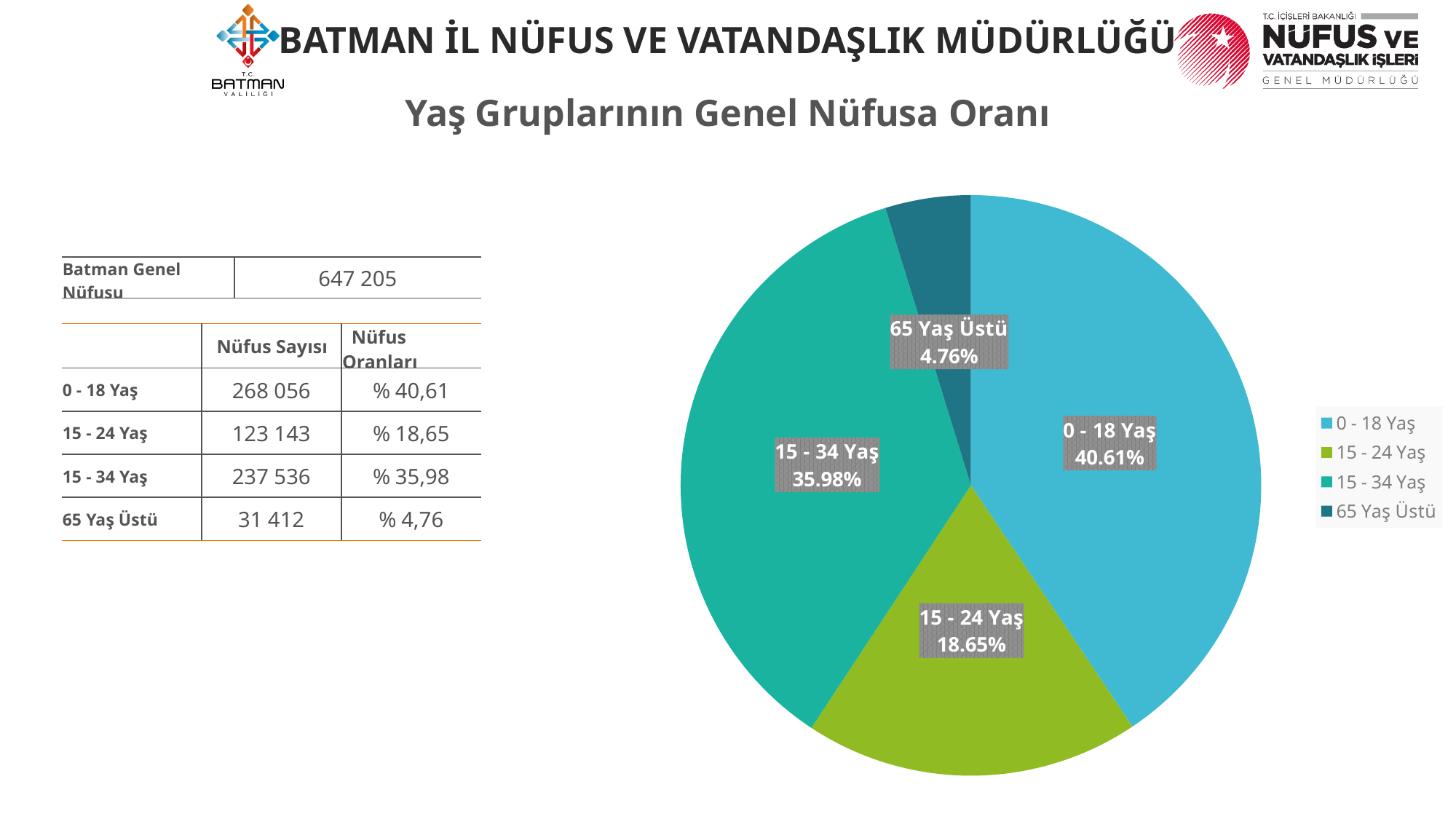
What kind of chart is shown on the slide? Pie chart What percentage does the pie chart show for the 65 Yaş Üstü slice? 4.76% What percentage does the pie chart show for the 0 - 18 Yaş slice? 40.61% What is the difference in percentage points between the 0 - 18 Yaş slice and the 15 - 34 Yaş slice? 4.63 What percentage does the pie chart show for the 15 - 34 Yaş slice? 35.98% What is the difference in percentage points between the 15 - 24 Yaş slice and the 65 Yaş Üstü slice? 13.89 How many slices does the pie chart have? 4 Which slice of the pie chart is the largest? 0 - 18 Yaş Which slice of the pie chart is the smallest? 65 Yaş Üstü What percentage does the pie chart show for the 15 - 24 Yaş slice? 18.65% How many entries does the pie chart's legend list? 4 Which slice is larger in the pie chart, 15 - 24 Yaş or 15 - 34 Yaş? 15 - 34 Yaş